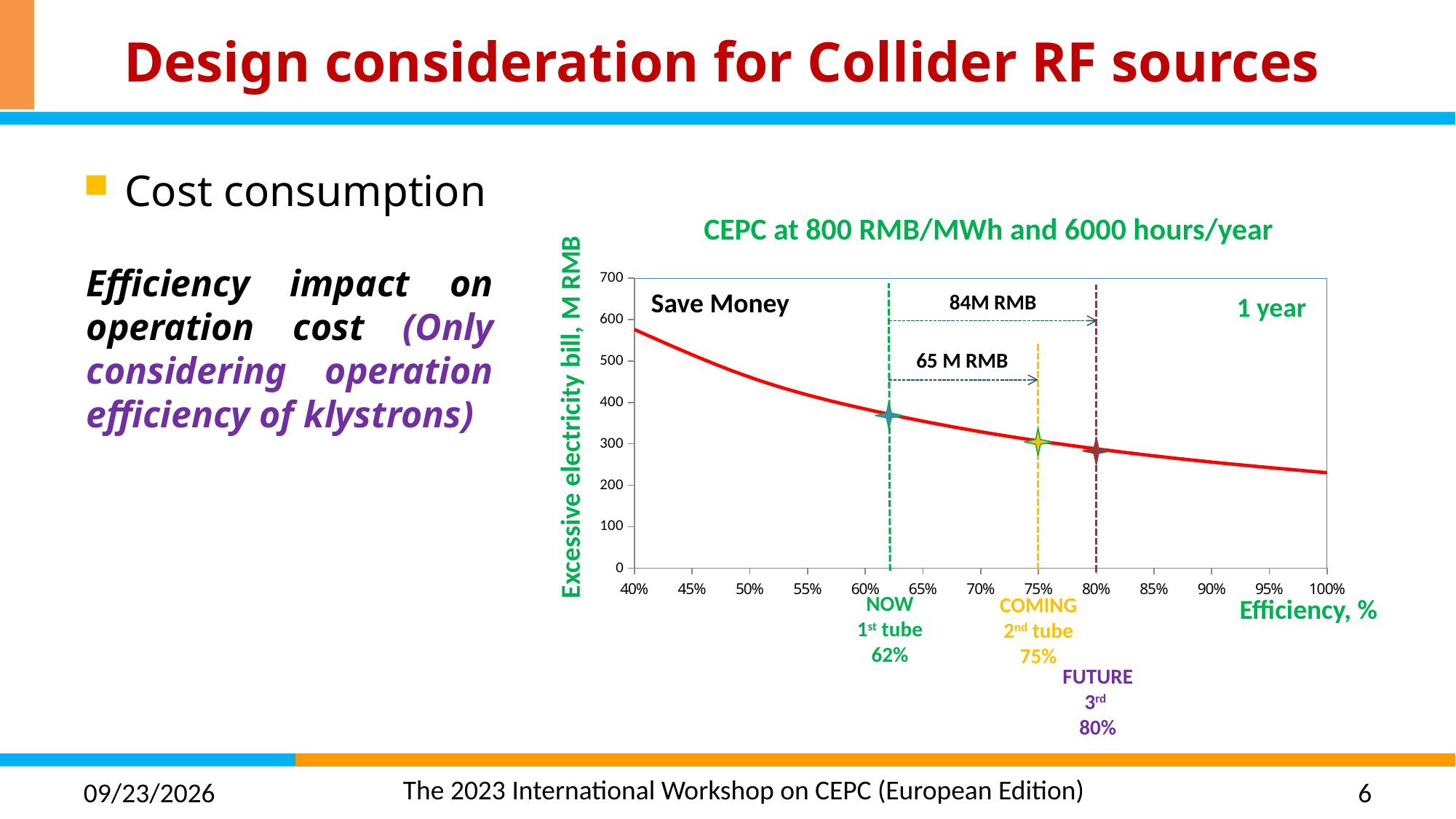
What kind of chart is shown on the slide? line chart What is the title of the chart? CEPC at 800 RMB/MWh and 6000 hours/year Is the excessive electricity bill at 62% efficiency greater or less than 300 M RMB? greater Is the excessive electricity bill at 100% efficiency greater or less than 300 M RMB? less How much money is saved per year by going from the 1st tube (62%) to the 2nd tube (75%), according to the annotation? 65 M RMB What is the efficiency of the NOW 1st tube marked on the chart? 62% What is the efficiency of the FUTURE 3rd tube marked on the chart? 80% Is the excessive electricity bill at 40% efficiency greater or less than 500 M RMB? greater What is the efficiency of the COMING 2nd tube marked on the chart? 75% Does the excessive electricity bill rise or fall as efficiency increases along the x axis? fall How much money is saved per year by going from the 1st tube (62%) to the 3rd tube (80%), according to the annotation? 84M RMB How many tube operating points are marked with stars on the curve? 3